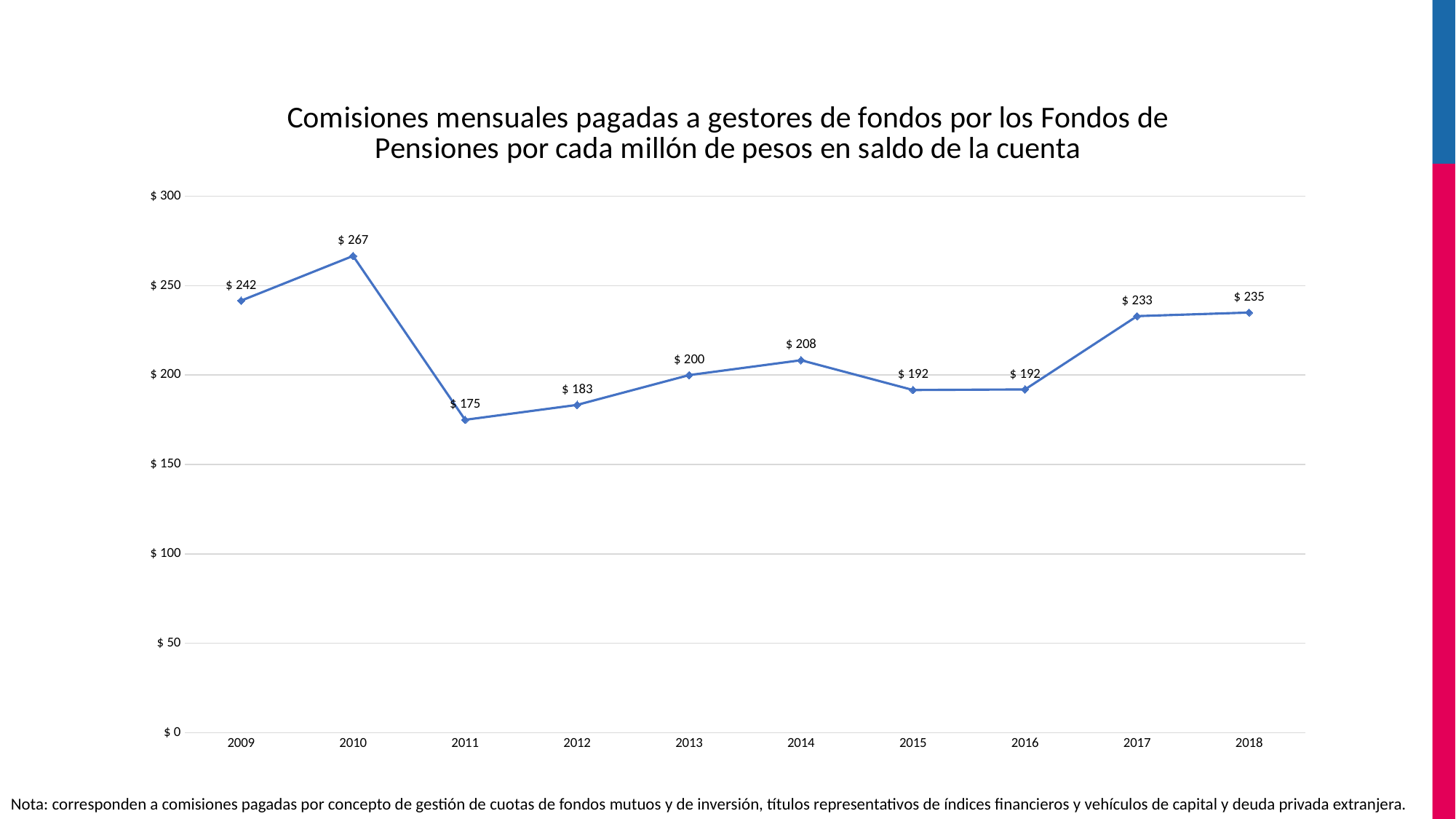
What kind of chart is shown? line chart Which year has the highest value? 2010 Which is larger, the value for 2009 or the value for 2013? 2009 What is the difference between the values for 2010 and 2011? $ 92 What is the value for 2014? $ 208 Do the values rise or fall from 2014 to 2015? fall How many years are plotted on the x axis? 10 What is the difference between the values for 2018 and 2017? $ 2 What is the value for 2018? $ 235 What is the value for 2010? $ 267 Is the value for 2012 greater or less than $ 200? less Which year has the lowest value? 2011